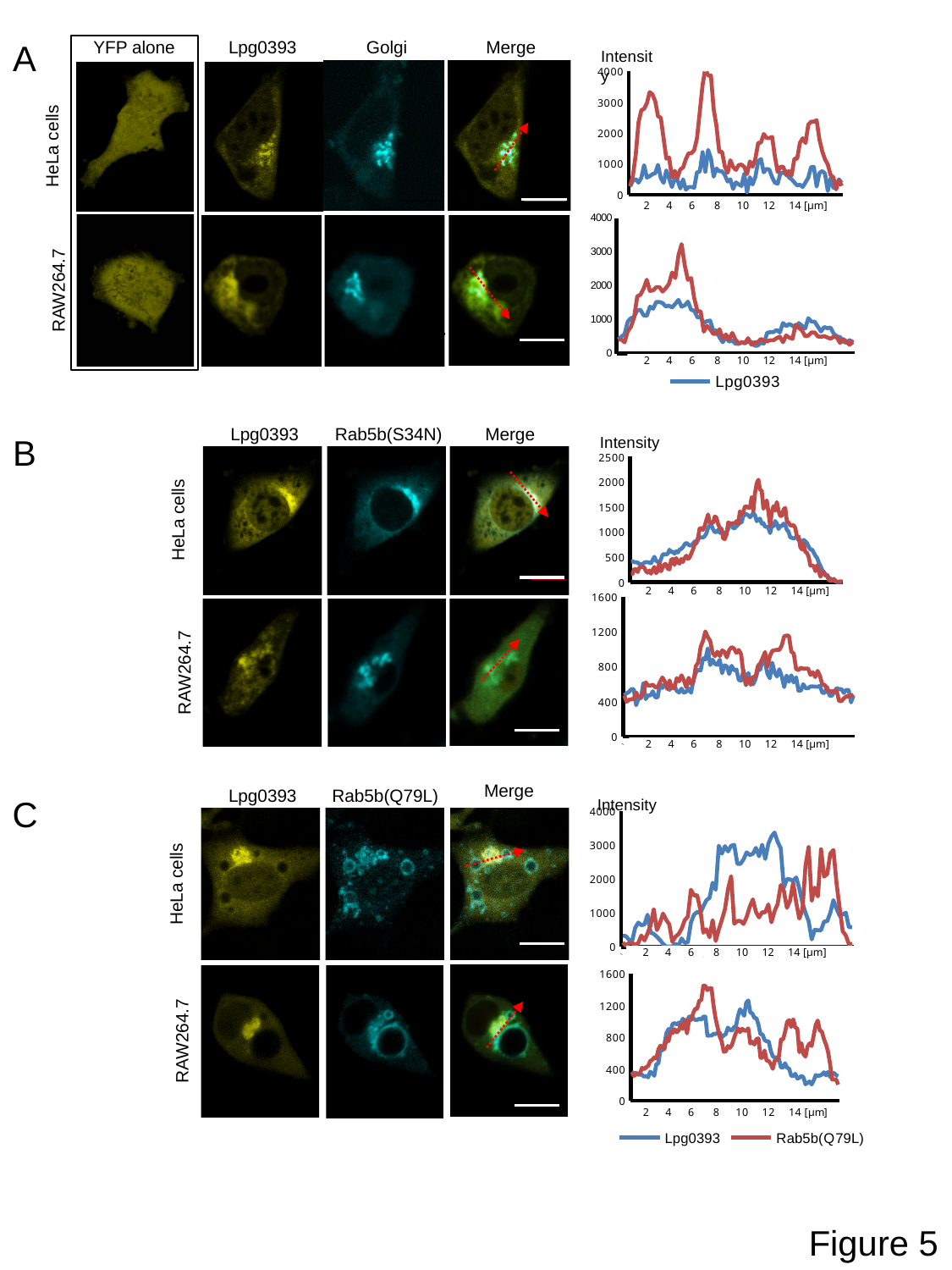
How many series does the legend below the panel C charts list? 2 In the panel A RAW264.7 intensity chart, is the peak value of the red line near 5 µm greater or less than 2000? greater What is the highest tick value on the y axis of the panel B HeLa cells intensity chart? 2500 In the panel A HeLa cells intensity chart, is the maximum value of the blue Lpg0393 line greater or less than 2000? less In the panel C RAW264.7 intensity chart, is the peak value of the red Rab5b(Q79L) line near 7 µm greater or less than 1200? greater In the panel C legend, which series is drawn in red? Rab5b(Q79L) How many intensity profile line charts are shown on the slide in total? 6 What kind of chart is the intensity profile chart in panel A for HeLa cells? line chart